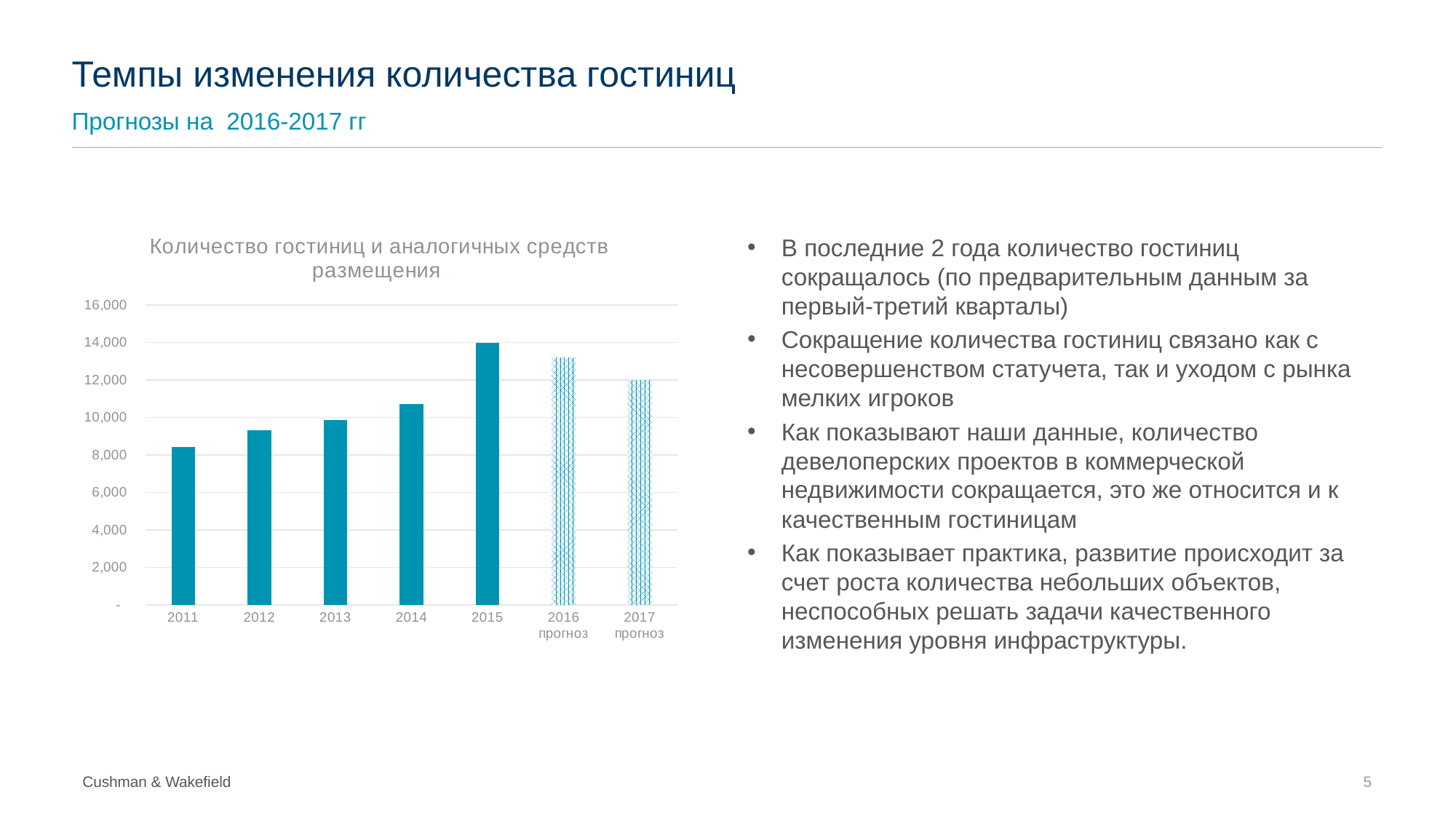
Do the values rise or fall from 2011 to 2015? rise What type of chart is shown on the slide? bar chart Which year has the lowest value in the chart? 2011 What is the title of the chart? Количество гостиниц и аналогичных средств размещения How many categories (years) are shown on the x axis of the chart? 7 Is the value for 2016 прогноз greater or less than 12,000? greater Is the value for 2011 greater or less than 8,000? greater Which two categories are drawn with a hatched (patterned) fill instead of a solid fill? 2016 прогноз and 2017 прогноз Which is larger, the value for 2015 or the value for 2017 прогноз? 2015 Which year has the highest value in the chart? 2015 Is the value for 2014 greater or less than 10,000? greater